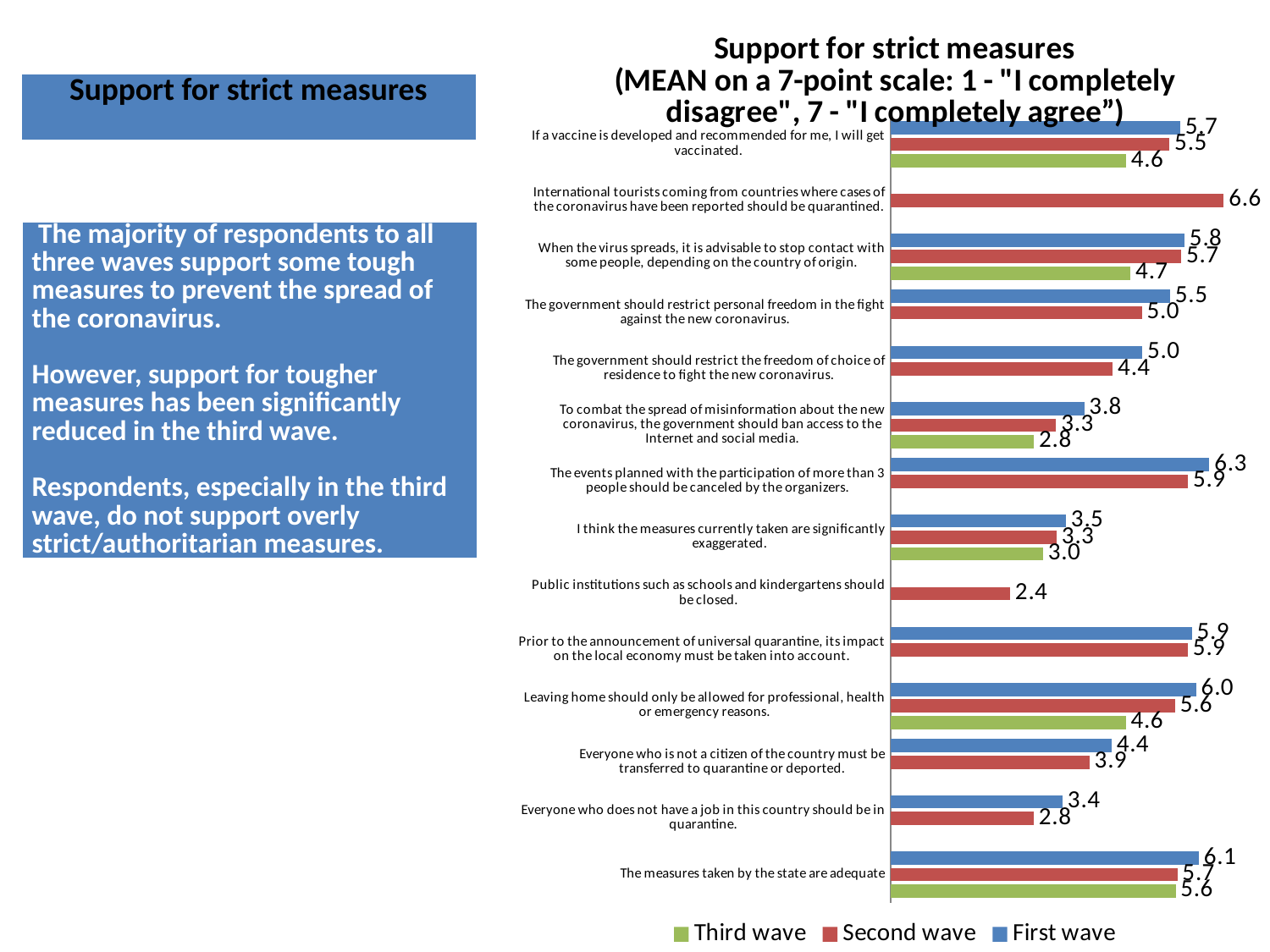
What is the Second wave value for "International tourists coming from countries where cases of the coronavirus have been reported should be quarantined"? 6.6 How many statements (categories) are shown in the chart? 14 How many series does the legend list? 3 For "Everyone who does not have a job in this country should be in quarantine", which is larger: the First wave value or the Second wave value? First wave What kind of chart is shown on the slide? Bar chart What is the Second wave value for "Public institutions such as schools and kindergartens should be closed"? 2.4 Which statement has the highest First wave value? The events planned with the participation of more than 3 people should be canceled by the organizers. Which statement has the lowest Third wave value? To combat the spread of misinformation about the new coronavirus, the government should ban access to the Internet and social media. What is the First wave value for "The measures taken by the state are adequate"? 6.1 What is the difference between the First wave and Third wave values for "If a vaccine is developed and recommended for me, I will get vaccinated"? 1.1 Which colour represents the Second wave in the chart? Red What is the Third wave value for "Leaving home should only be allowed for professional, health or emergency reasons"? 4.6